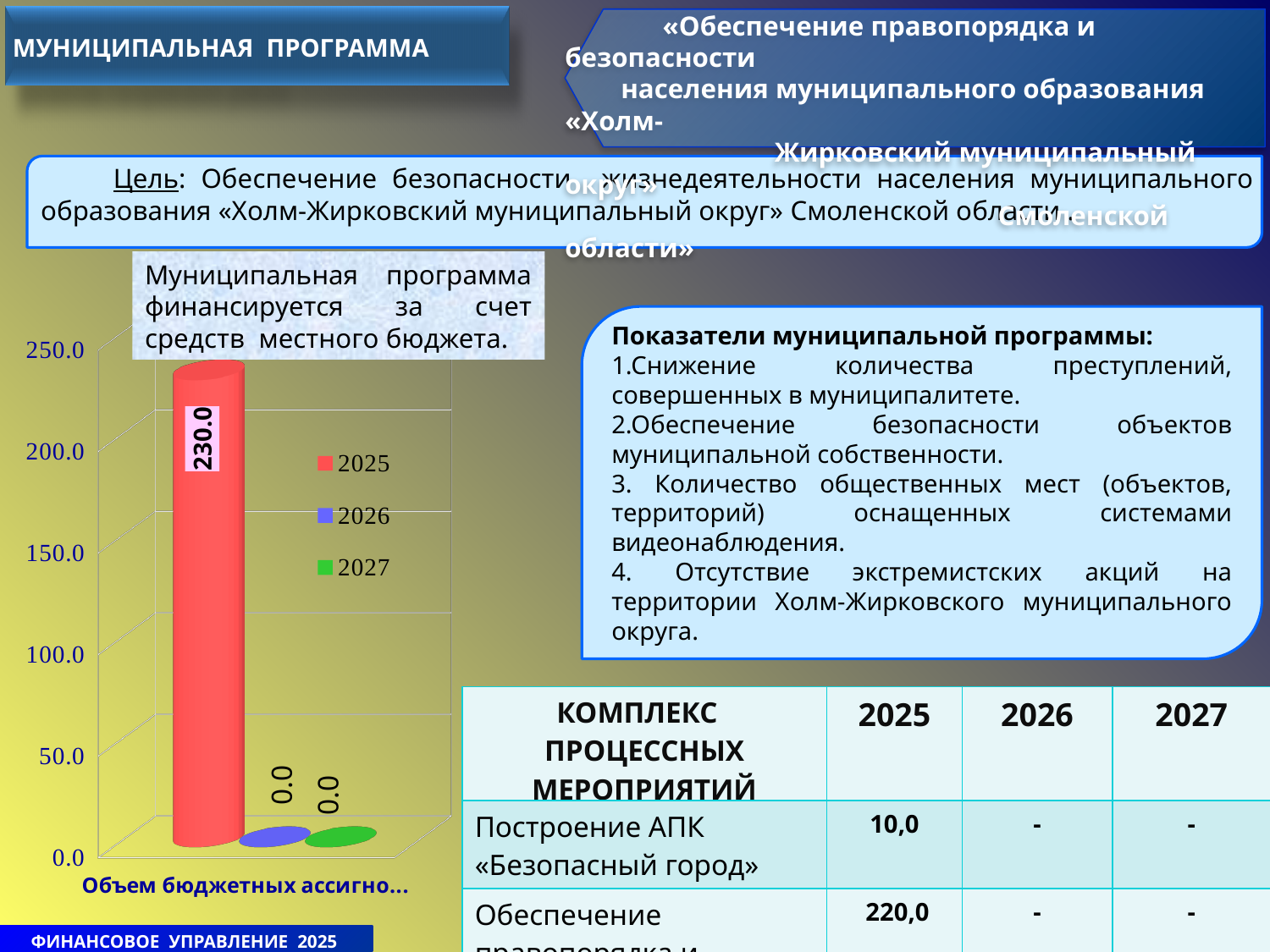
Is the value for 2025 in the chart greater or less than 250.0? less Which series has the highest value in the chart? 2025 What is the value for the 2025 series in the chart? 230.0 What is the value for the 2027 series in the chart? 0.0 What kind of chart is shown on the slide? bar chart What is the highest value shown on the chart's vertical axis? 250.0 How many series does the chart legend list? 3 What is the value for the 2026 series in the chart? 0.0 What is the difference between the 2025 value and the 2026 value in the chart? 230.0 Which is larger in the chart, the value for 2025 or the value for 2027? 2025 What colour is the bar for the 2025 series in the chart? red Is the value for 2025 in the chart greater or less than 200.0? greater